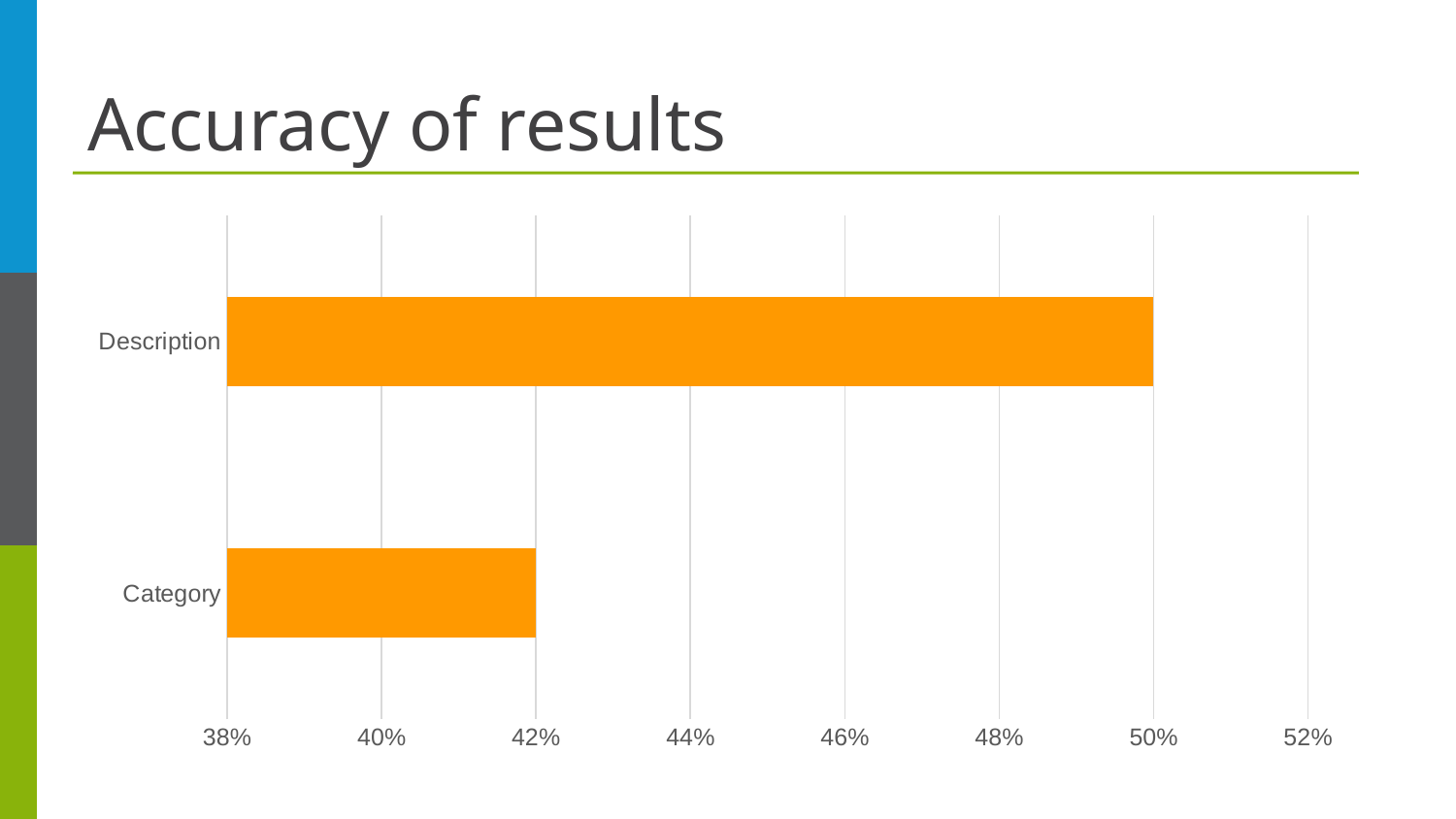
How many categories are plotted in the chart? 2 Which is larger, the value for Description or the value for Category? Description What is the title of the chart? Accuracy of results What is the value for Description? 50% What is the value for Category? 42% Is the value for Description greater or less than 46%? greater What colour are the bars in the chart? orange Which category has the highest value? Description Is the value for Category greater or less than 44%? less Which category has the lowest value? Category What kind of chart is shown on the slide? bar chart What is the difference between the values for Description and Category? 8%